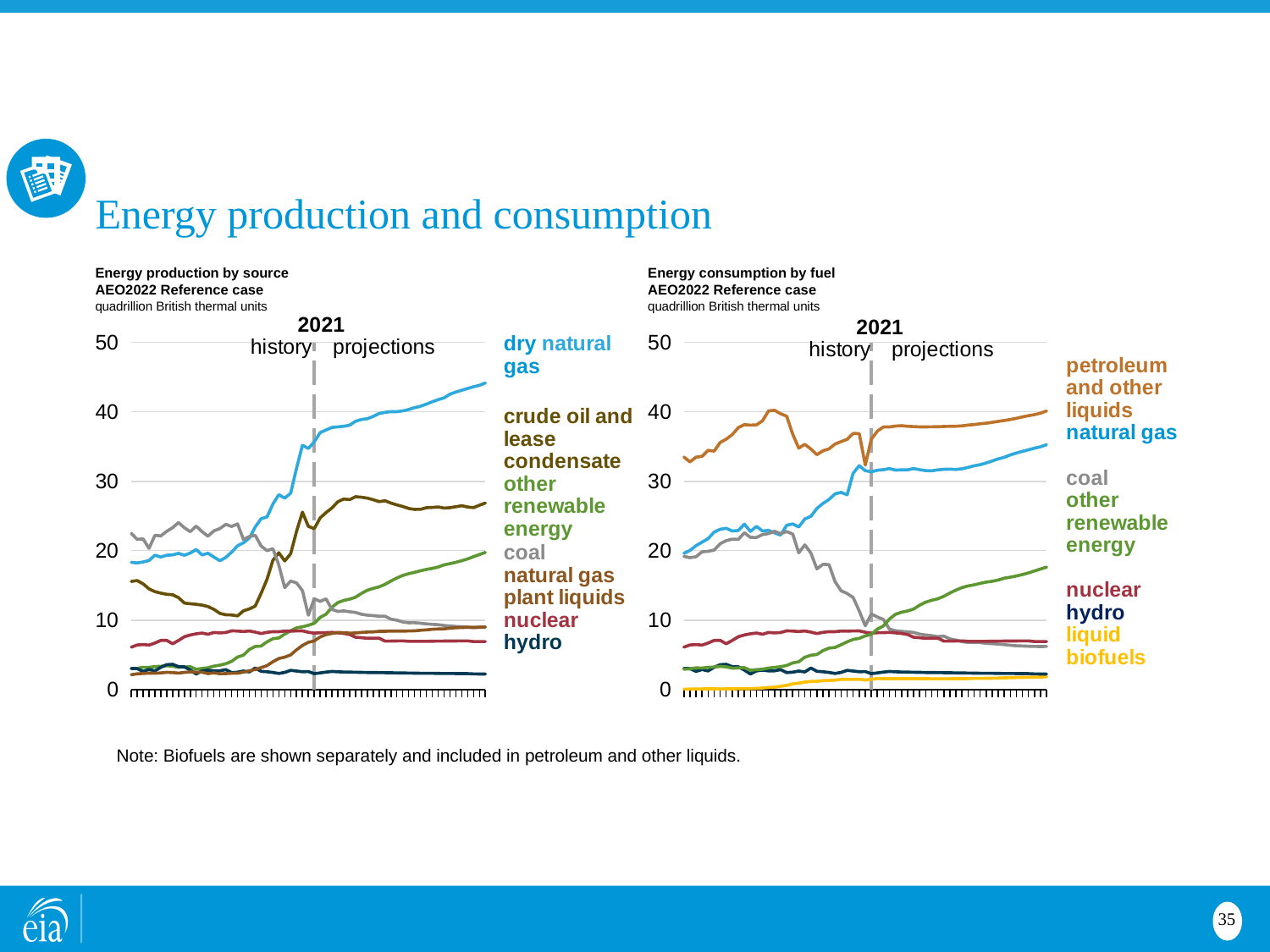
In the 'Energy consumption by fuel' chart, does other renewable energy consumption rise or fall over the projection period? rise What type of chart is the 'Energy production by source' chart? line chart In the 'Energy consumption by fuel' chart, is the value for other renewable energy at the end of the projection period greater or less than 20? less In the 'Energy consumption by fuel' chart, which fuel has the highest value at the end of the projection period? petroleum and other liquids In the 'Energy production by source' chart, is the value for dry natural gas at the end of the projection period greater or less than 40? greater In the 'Energy production by source' chart, does coal production rise or fall over the projection period? fall In the 'Energy production by source' chart, which source has the highest value at the end of the projection period? dry natural gas How many series are labelled on the 'Energy consumption by fuel' chart? 7 What year marks the boundary between history and projections on both charts? 2021 In the 'Energy consumption by fuel' chart, is the value for natural gas at the end of the projection period greater or less than 30? greater How many series are labelled on the 'Energy production by source' chart? 7